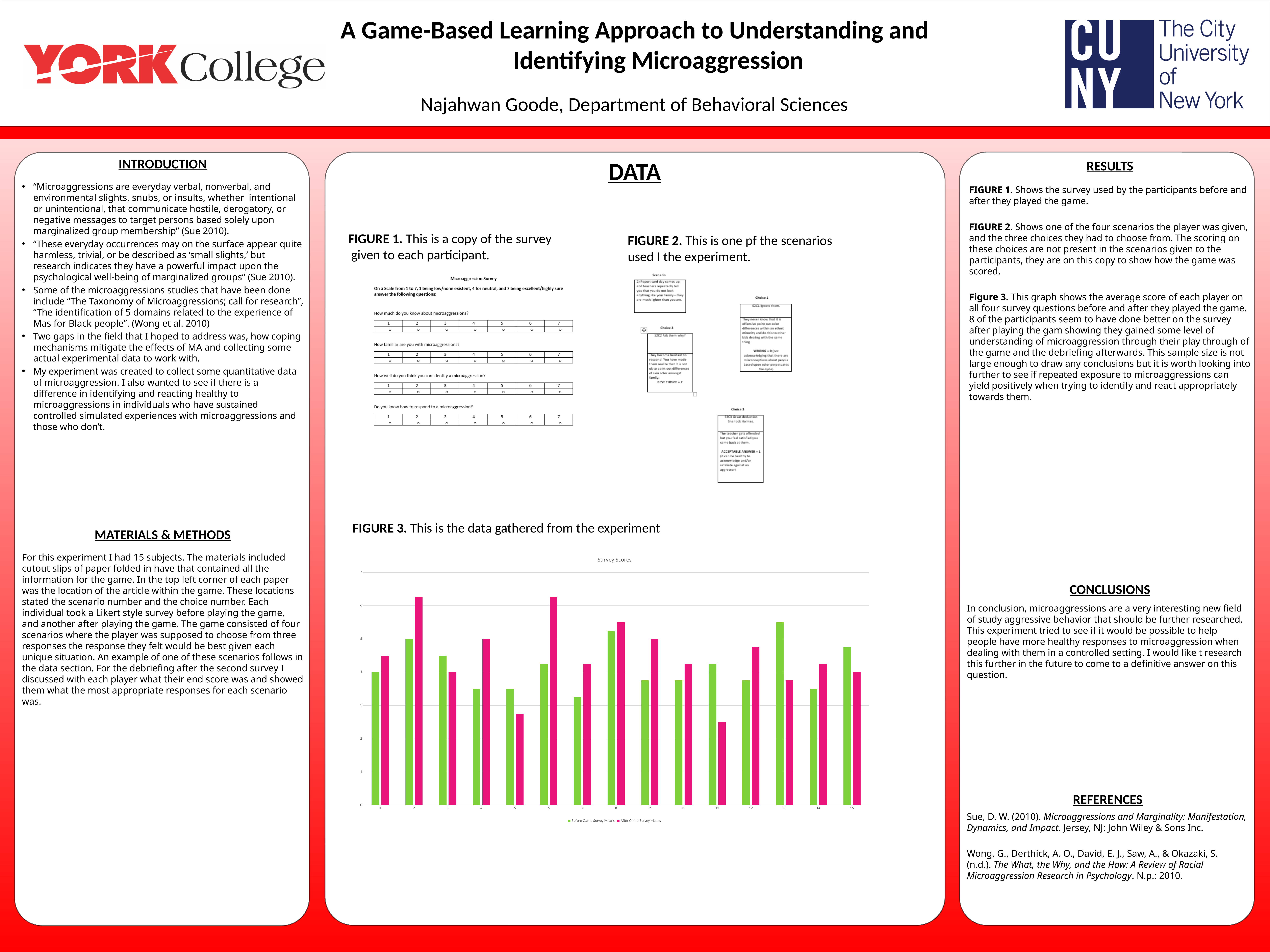
In the Survey Scores chart, is the Before Game Survey Means value for participant 13 greater or less than 5? greater In the Survey Scores chart, is the Before Game Survey Means value for participant 7 greater or less than 4? less In the Survey Scores chart, is the After Game Survey Means value for participant 11 greater or less than 3? less How many series does the legend of the Survey Scores chart list? 2 How many participants (categories) are shown on the x axis of the Survey Scores chart? 15 What kind of chart is the Figure 3 chart titled "Survey Scores"? bar chart In the Survey Scores chart, for participant 11, which is larger: the Before Game Survey Means or the After Game Survey Means? Before Game Survey Means In the Survey Scores chart, for participant 13, which is larger: the Before Game Survey Means or the After Game Survey Means? Before Game Survey Means In the Survey Scores chart, which series is shown in green? Before Game Survey Means What is the title of the chart in Figure 3? Survey Scores In the Survey Scores chart, for participant 2, which is larger: the Before Game Survey Means or the After Game Survey Means? After Game Survey Means